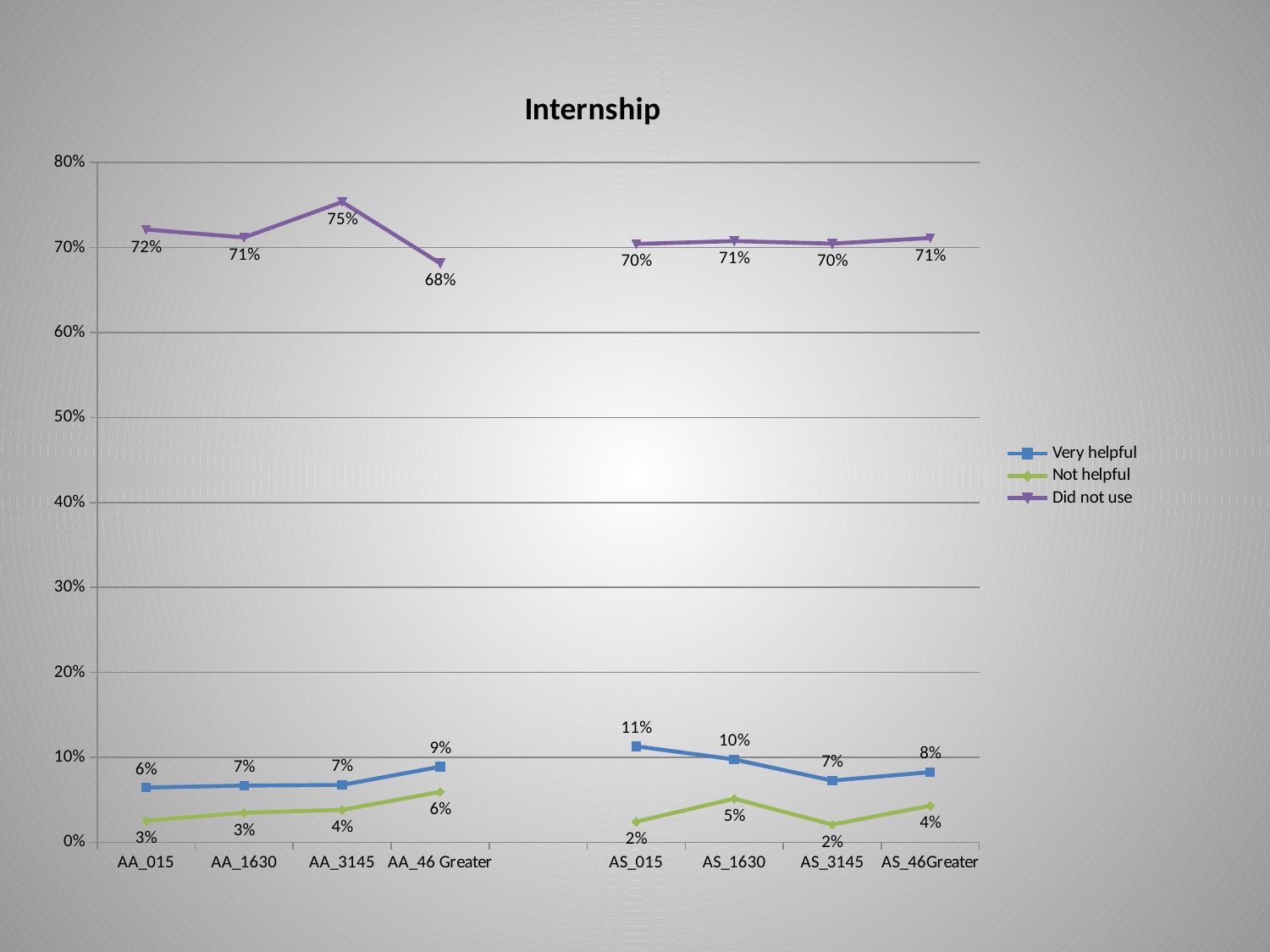
Which is larger, the 'Very helpful' value for AS_015 or for AS_3145? AS_015 What is the 'Not helpful' value for AA_46 Greater? 6% How many series does the legend list? 3 What is the 'Did not use' value for AA_3145? 75% Which series is shown in purple in the legend? Did not use What type of chart is shown on the slide? line chart Which category has the lowest 'Did not use' value? AA_46 Greater What is the 'Very helpful' value for AS_015? 11% What is the title of the chart? Internship What is the difference between the 'Did not use' values for AA_3145 and AA_46 Greater? 7% Is the 'Did not use' value for AS_1630 greater or less than 60%? greater Which category has the highest 'Did not use' value? AA_3145